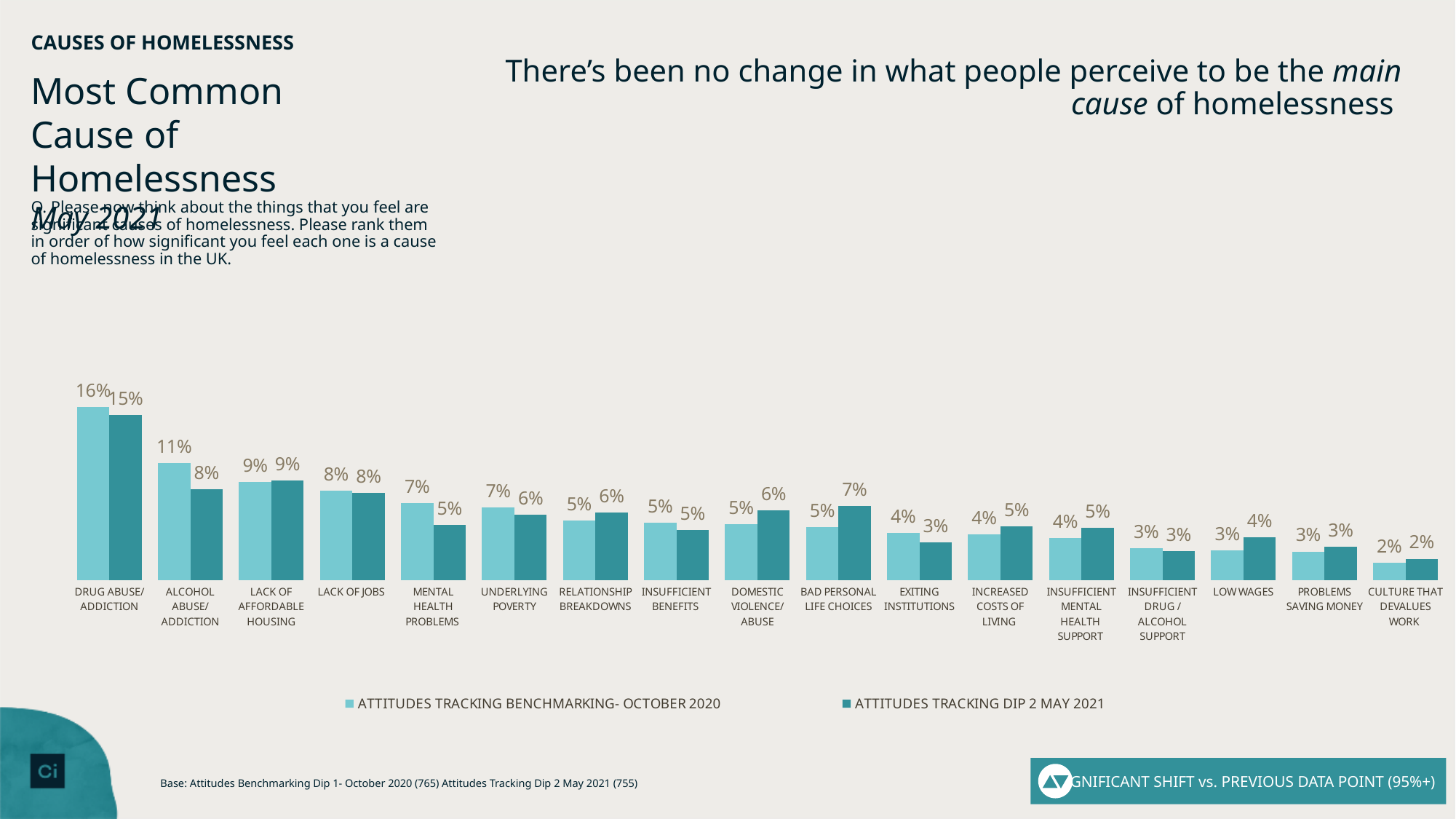
What is the name of the second series in the legend? Attitudes Tracking Dip 2 May 2021 Which is larger for Bad personal life choices: the October 2020 value or the May 2021 value? May 2021 What is the value for Alcohol abuse/addiction in the Attitudes Tracking Benchmarking - October 2020 series? 11% How many series does the legend list? 2 Which category has the lowest value in the May 2021 series? Culture that devalues work What is the value for Drug abuse/addiction in the Attitudes Tracking Dip 2 May 2021 series? 15% What is the difference between the October 2020 and May 2021 values for Alcohol abuse/addiction? 3% Do the October 2020 values generally rise or fall from left to right along the x axis? Fall What is the value for Bad personal life choices in the May 2021 series? 7% How many categories are shown on the x axis? 17 Which category has the highest value in the October 2020 series? Drug abuse/addiction What kind of chart is shown on the slide? Bar chart